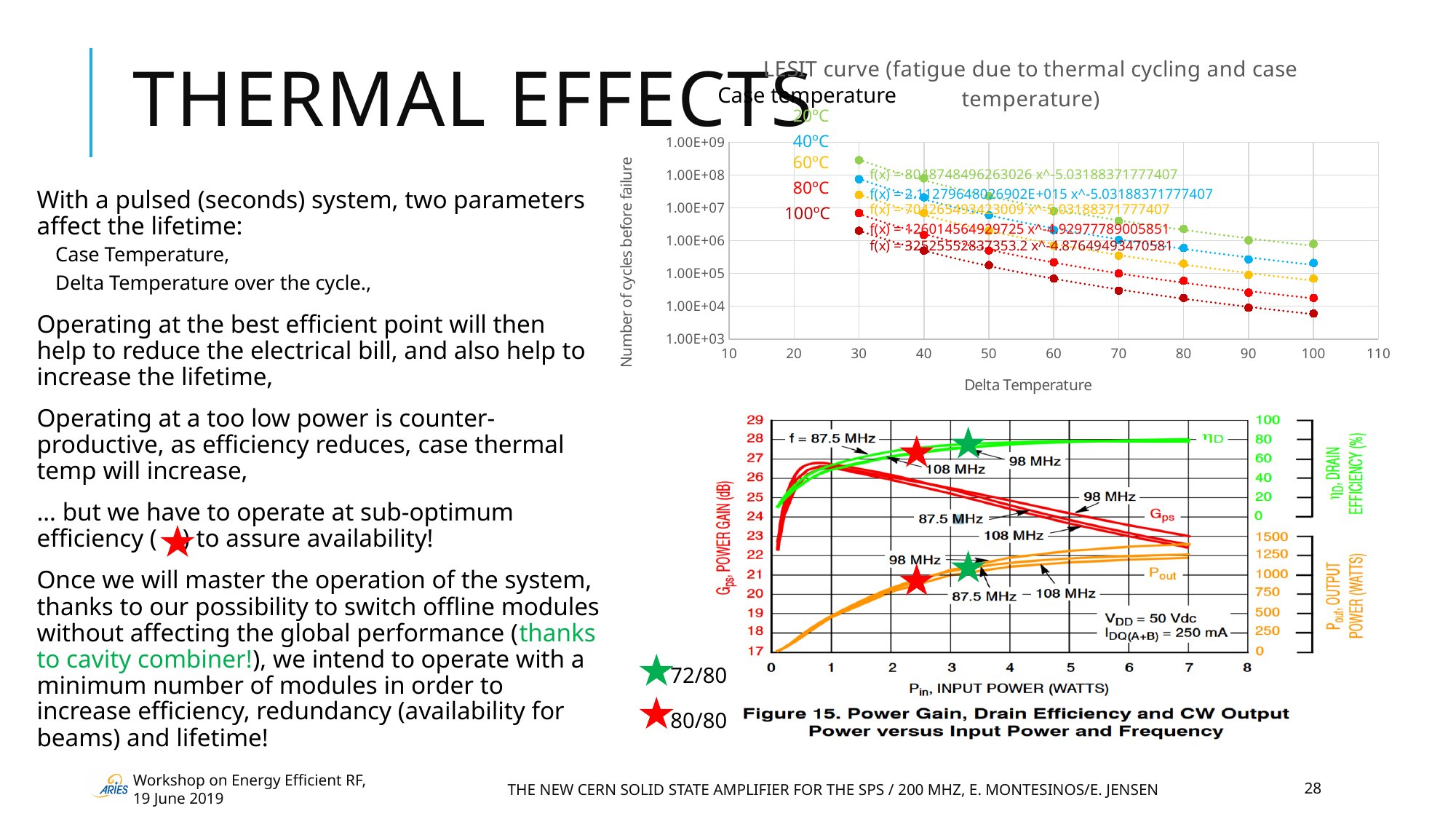
In the LESIT curve chart, which case temperature series has the lowest number of cycles before failure at every Delta Temperature? 100°C In the LESIT curve chart, is the value for the 20°C series at Delta Temperature 30 greater or less than 1.00E+08? greater In Figure 15, what is the label of the x axis? Pin, INPUT POWER (WATTS) In the LESIT curve chart, is the value for the 100°C series at Delta Temperature 100 greater or less than 1.00E+04? less In the LESIT curve chart, how many case temperature series does the legend list? 5 In Figure 15, how many frequencies are plotted for each quantity? 3 In the LESIT curve chart, what is the label of the y axis? Number of cycles before failure In the LESIT curve chart, do the number of cycles before failure rise or fall as Delta Temperature increases? fall In the LESIT curve chart, at Delta Temperature 50, which case temperature series has more cycles before failure: 20°C or 100°C? 20°C In the LESIT curve chart, what is the label of the x axis? Delta Temperature What kind of chart is Figure 15 (Power Gain, Drain Efficiency and CW Output Power versus Input Power and Frequency)? line chart In the LESIT curve chart, how many data points are plotted for each case temperature series? 8